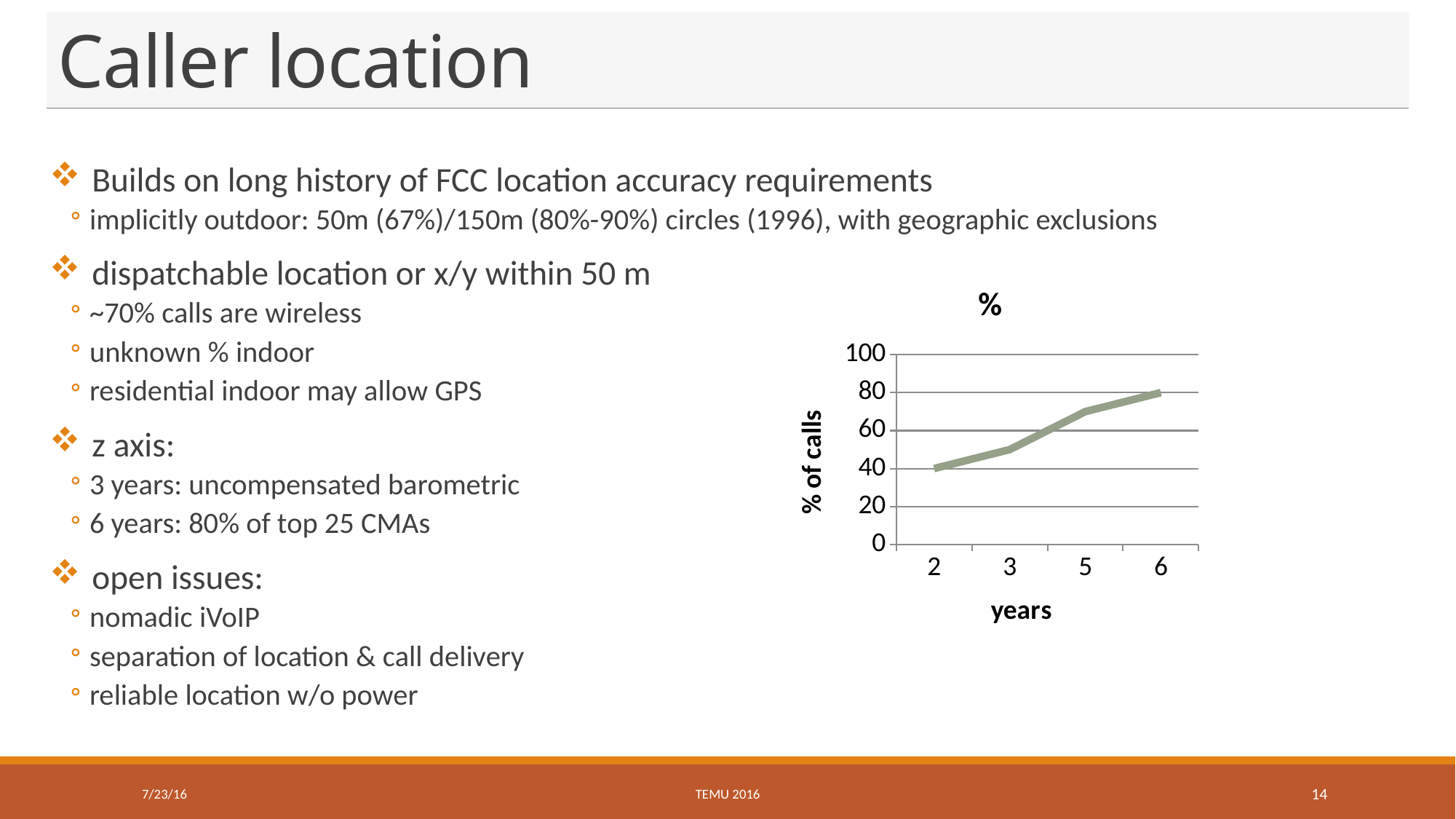
What kind of chart is shown on the slide? line chart What is the % of calls at year 2? 40 How many data points are plotted on the chart? 4 What is the % of calls at year 6? 80 Is the value for year 5 greater or less than 60? greater What is the difference in % of calls between year 6 and year 2? 40 Which year has the lowest % of calls on the chart? 2 Which year has the highest % of calls on the chart? 6 Which has a higher % of calls, year 3 or year 5? year 5 Is the value for year 3 greater or less than 60? less What is the label on the vertical axis of the chart? % of calls Do the values on the chart rise or fall as the years increase? rise